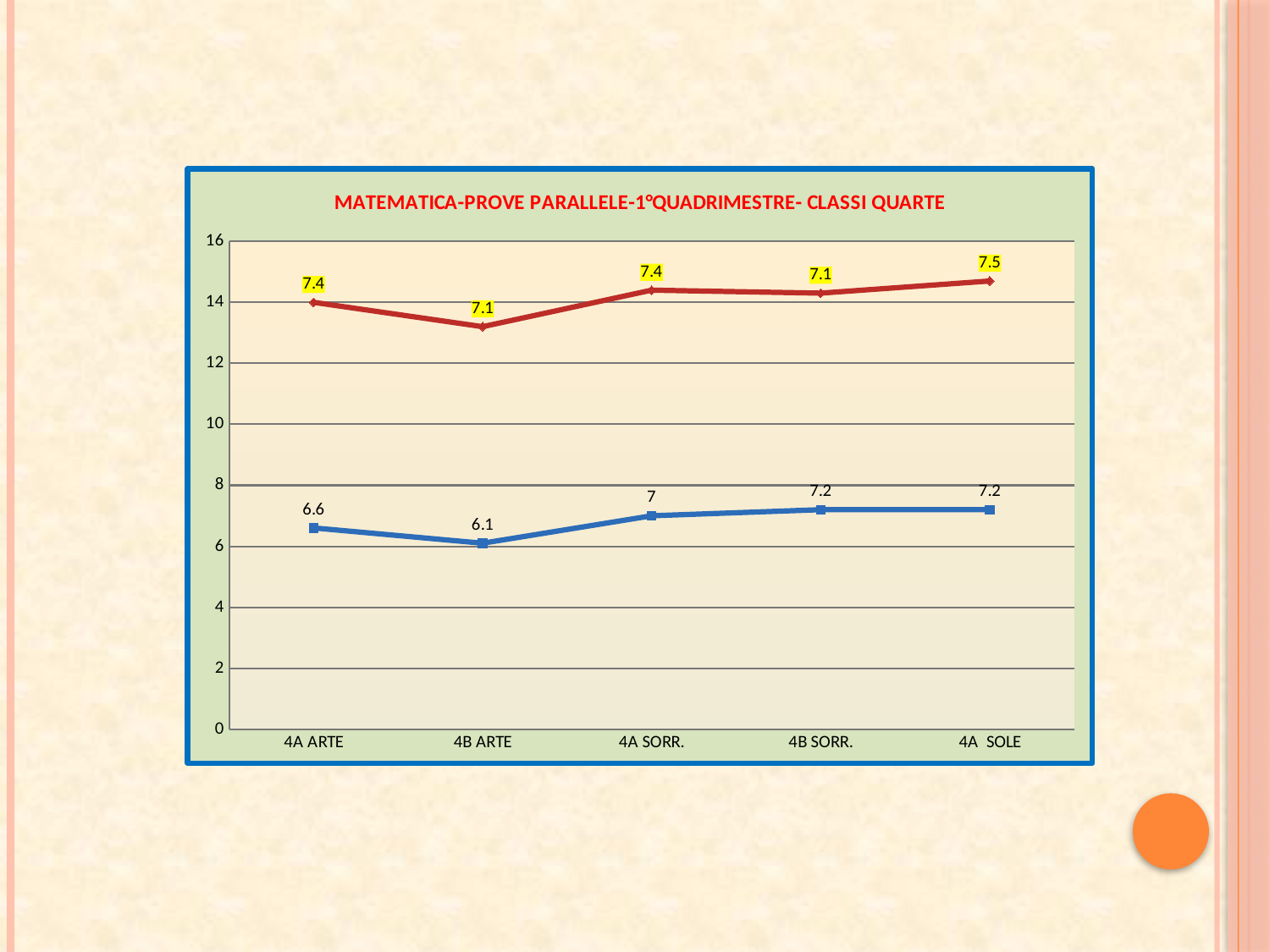
What is the data label on the red line for 4B SORR.? 7.1 Does the blue line rise or fall from 4B ARTE to 4A SORR.? rise What is the title of the chart? MATEMATICA-PROVE PARALLELE-1°QUADRIMESTRE- CLASSI QUARTE Which is larger, the blue-line data label for 4B SORR. or for 4A ARTE? 4B SORR. What is the data label on the red line for 4A SOLE? 7.5 What is the data label on the blue line for 4A ARTE? 6.6 How many classes are shown along the x axis of the chart? 5 Which class has the lowest data label on the blue line? 4B ARTE What kind of chart is shown on the slide? line chart Which class has the highest data label on the red line? 4A SOLE What is the data label on the blue line for 4B ARTE? 6.1 What is the difference between the blue-line data labels for 4A SORR. and 4B ARTE? 0.9